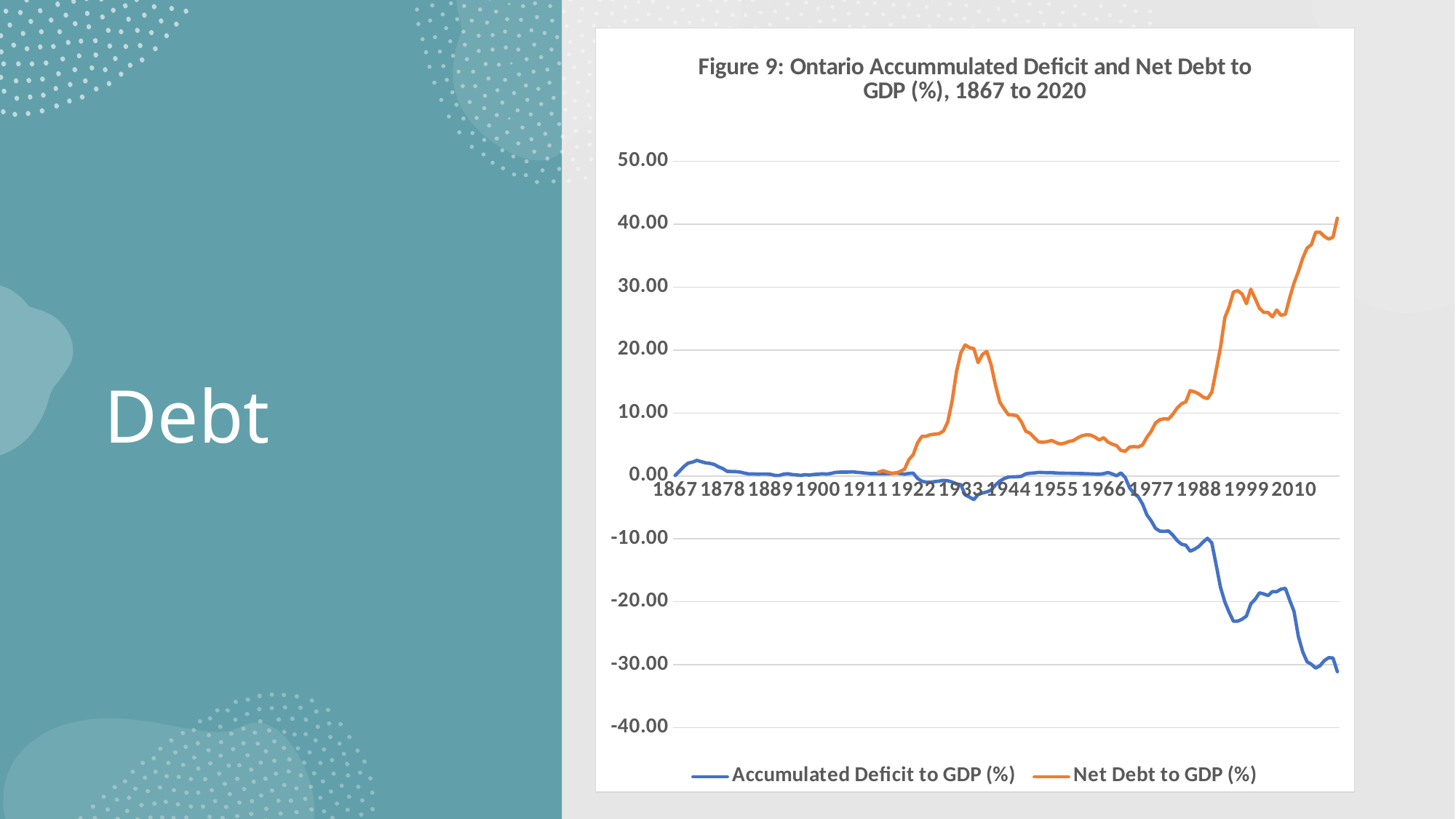
Is the value of Net Debt to GDP (%) at the end of the series (2020) greater or less than 30.00? greater What is the title of the chart? Figure 9: Ontario Accummulated Deficit and Net Debt to GDP (%), 1867 to 2020 Does Accumulated Deficit to GDP (%) rise or fall between 1966 and 2020? Fall Is the value of Net Debt to GDP (%) around 1933 greater or less than 10.00? greater How many series does the legend list? 2 Is the value of Accumulated Deficit to GDP (%) at 1999 greater or less than -10.00? less Which series is drawn in orange? Net Debt to GDP (%) What kind of chart is shown on the slide? Line chart At 2010, which series has the higher value, Accumulated Deficit to GDP (%) or Net Debt to GDP (%)? Net Debt to GDP (%) How many year labels are shown on the x axis? 14 Does Net Debt to GDP (%) rise or fall between 1977 and 2020? Rise